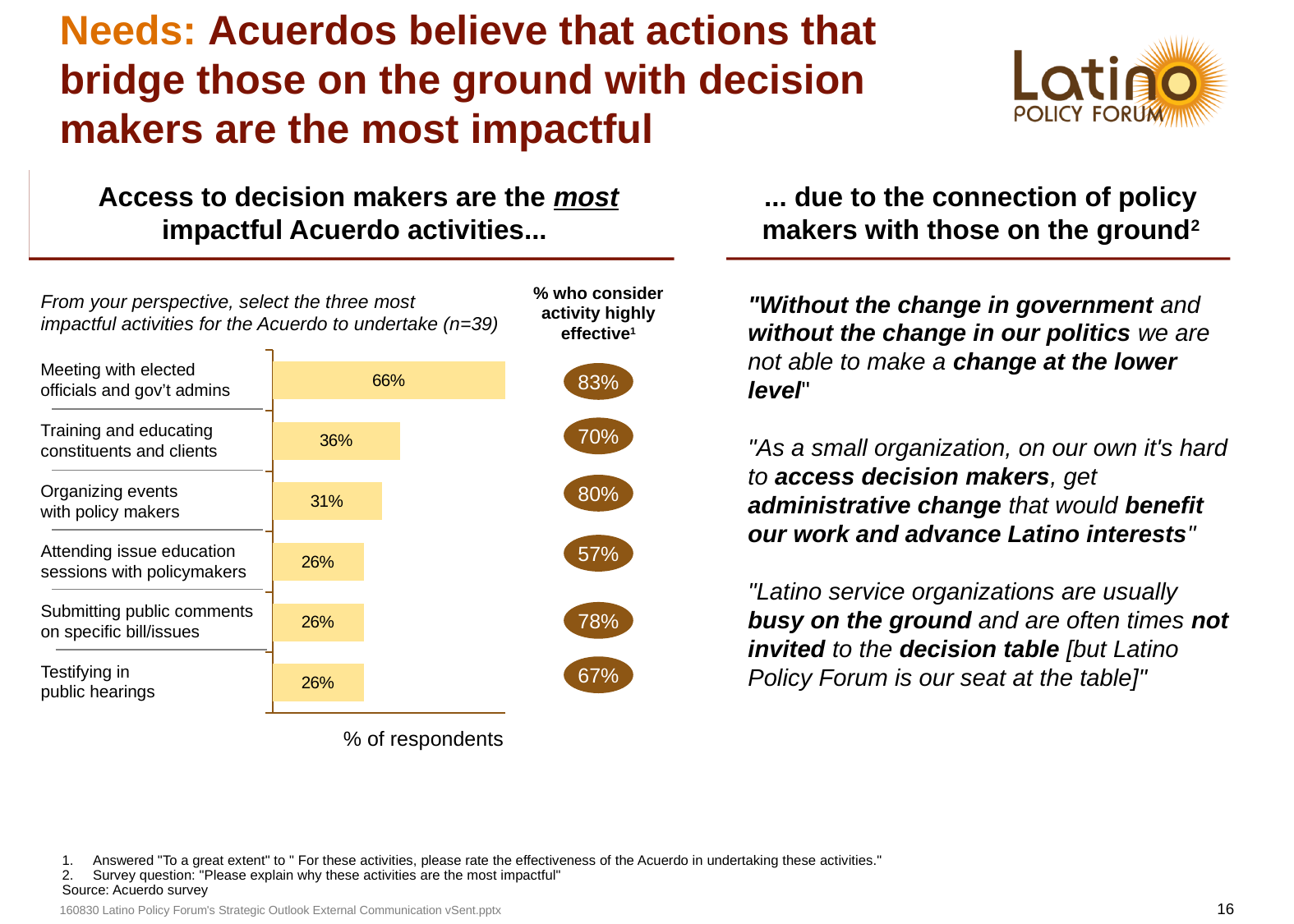
What kind of chart is used to show the % of respondents? Bar chart Which activity has the highest percentage of respondents in the bar chart? Meeting with elected officials and gov't admins What percentage of respondents selected "Meeting with elected officials and gov't admins" as one of the most impactful activities? 66% Which has a higher percentage of respondents: "Training and educating constituents and clients" or "Organizing events with policy makers"? Training and educating constituents and clients What percentage of respondents consider "Meeting with elected officials and gov't admins" highly effective? 83% Which activity has the lowest percentage of respondents who consider it highly effective? Attending issue education sessions with policymakers What is the difference in percentage points between "Meeting with elected officials and gov't admins" and "Training and educating constituents and clients"? 30 How many activities are shown in the bar chart? 6 What is the sample size (n) stated for the survey question in the chart? 39 What percentage of respondents selected "Training and educating constituents and clients"? 36% What percentage of respondents consider "Submitting public comments on specific bill/issues" highly effective? 78% What percentage of respondents selected "Organizing events with policy makers"? 31%